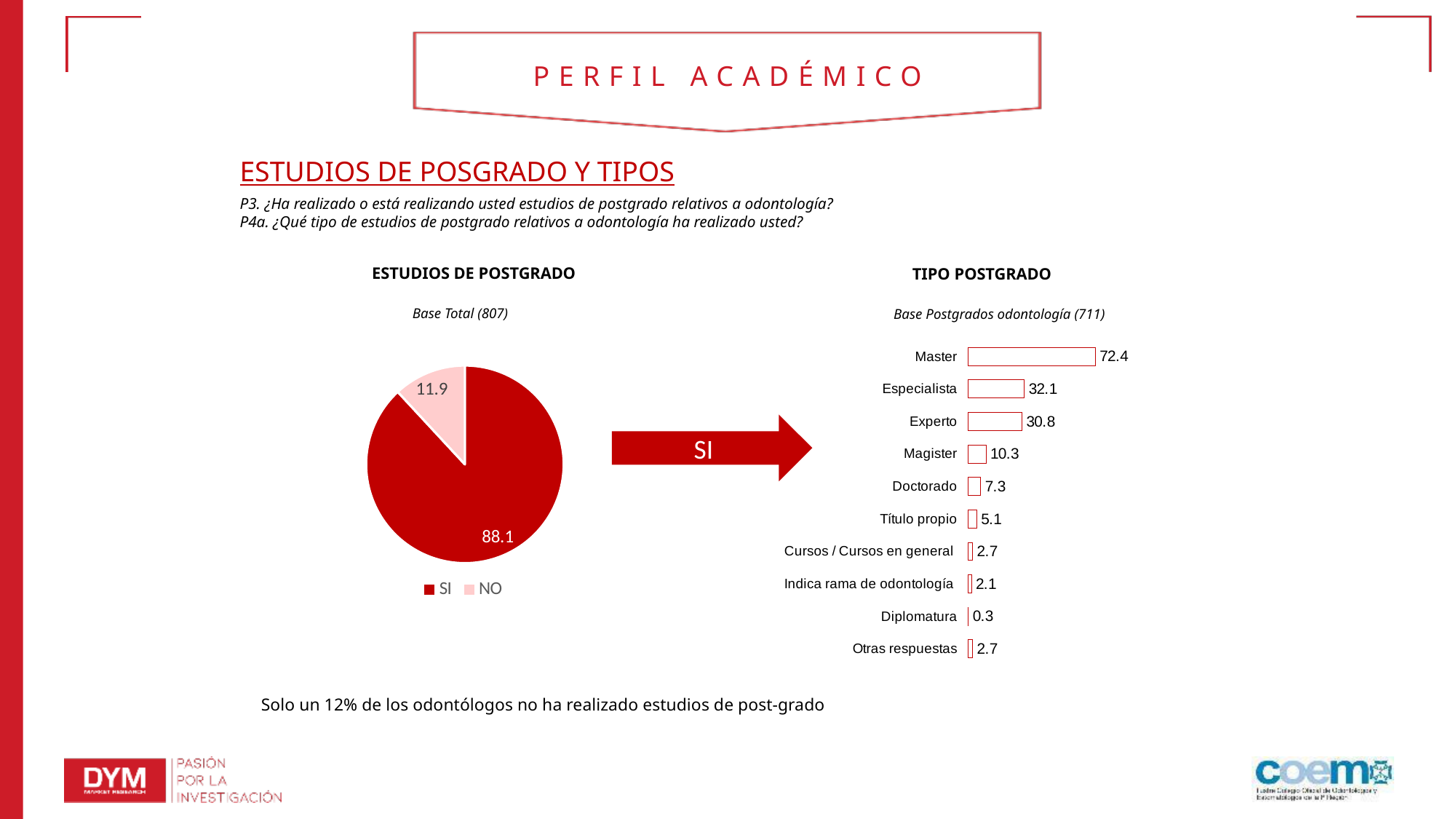
How many categories does the TIPO POSTGRADO chart show? 10 In the TIPO POSTGRADO chart, what is the value for Master? 72.4 What kind of chart is the TIPO POSTGRADO chart? Bar chart In the TIPO POSTGRADO chart, which category has the lowest value? Diplomatura What kind of chart is the ESTUDIOS DE POSTGRADO chart? Pie chart In the TIPO POSTGRADO chart, what is the difference between Especialista and Experto? 1.3 In the ESTUDIOS DE POSTGRADO pie chart, what is the value for SI? 88.1 How many entries does the legend of the ESTUDIOS DE POSTGRADO pie chart list? 2 In the ESTUDIOS DE POSTGRADO pie chart, what is the value for NO? 11.9 In the TIPO POSTGRADO chart, which is larger, Magister or Doctorado? Magister In the TIPO POSTGRADO chart, which category has the highest value? Master In the TIPO POSTGRADO chart, what is the value for Doctorado? 7.3